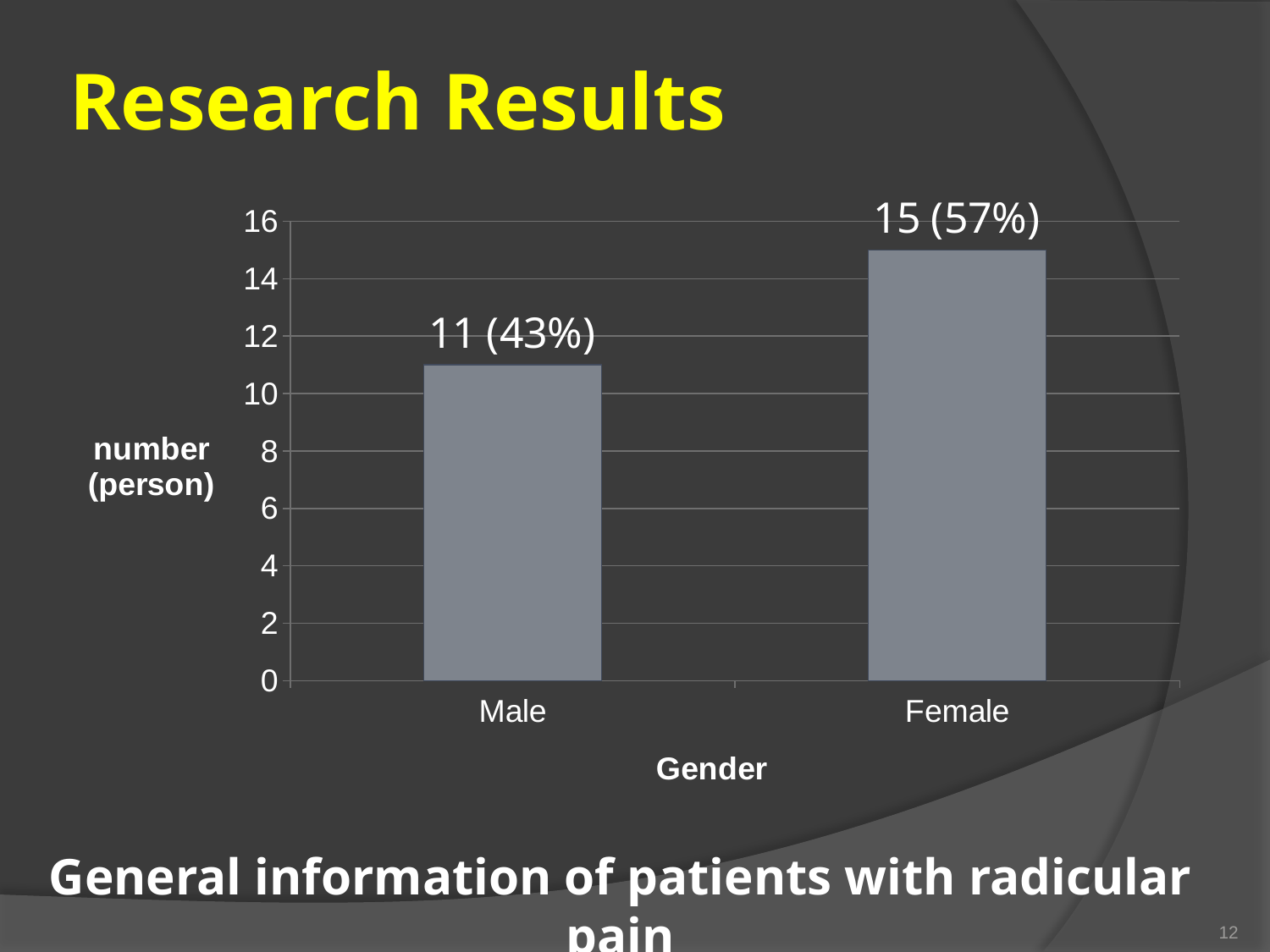
Which is larger, the number for Male or the number for Female? Female Which gender has the lowest number of patients? Male What is the value shown for Female? 15 (57%) Is the value for Male greater or less than 12? less What is the difference in number of persons between Female and Male? 4 Which gender has the highest number of patients? Female What is the label of the x axis? Gender How many categories are shown on the x axis? 2 What is the value shown for Male? 11 (43%) Is the value for Female greater or less than 14? greater What is the label of the y axis? number (person) What kind of chart is shown on the slide? bar chart